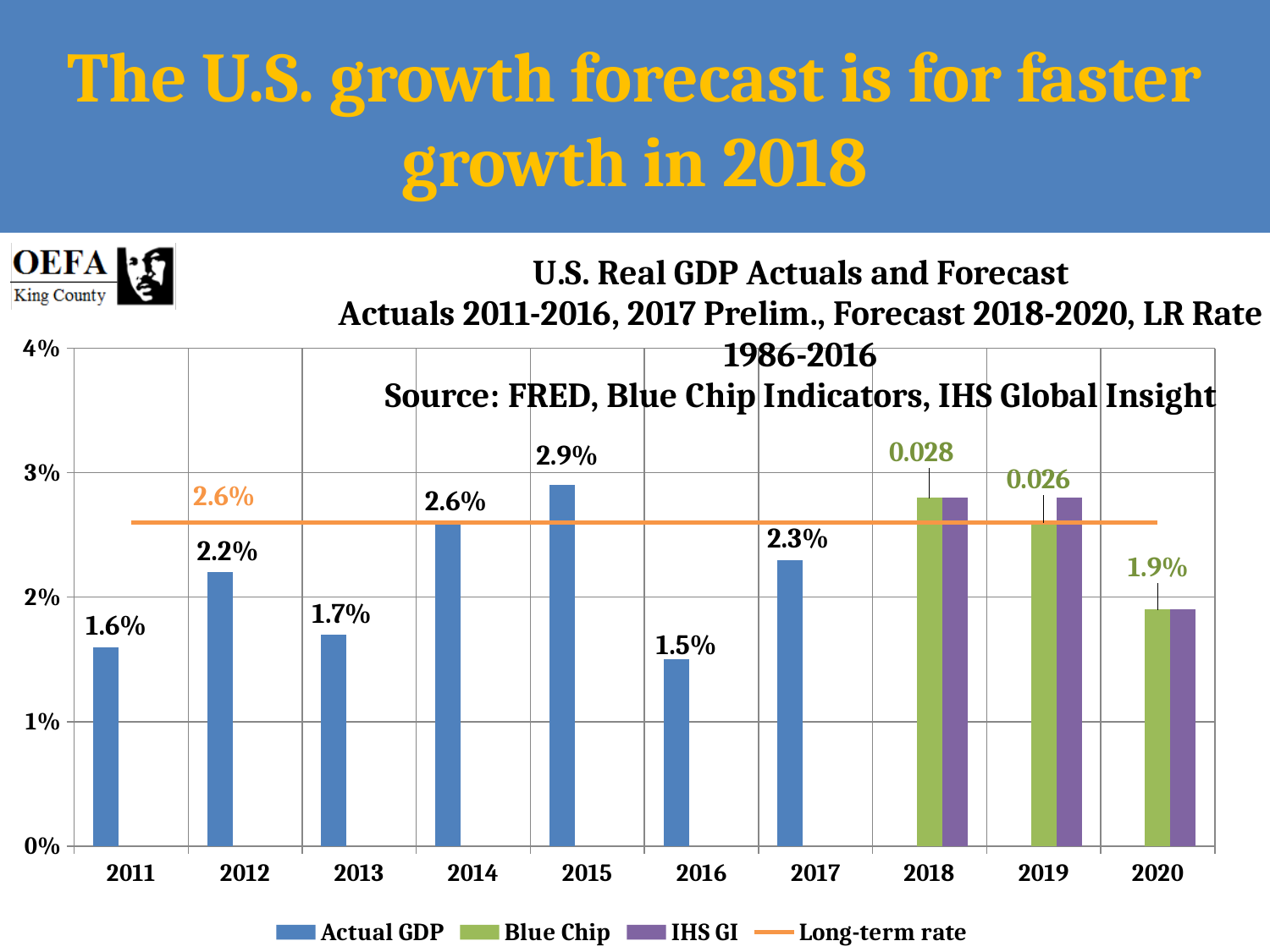
How many series does the legend list? 4 What is the Blue Chip forecast value labeled for 2018? 0.028 Which year has the highest Actual GDP value? 2015 What kind of chart is used to show the GDP values? bar chart Is the IHS GI value for 2018 greater or less than 2%? greater What is the value of the Long-term rate line? 2.6% Which year has the lowest Actual GDP value? 2016 What is the difference between the Actual GDP values for 2015 and 2016? 1.4% Which year has the larger Actual GDP value, 2012 or 2013? 2012 How many years are shown on the x axis? 10 What is the Actual GDP value for 2015? 2.9% What is the Actual GDP value for 2016? 1.5%